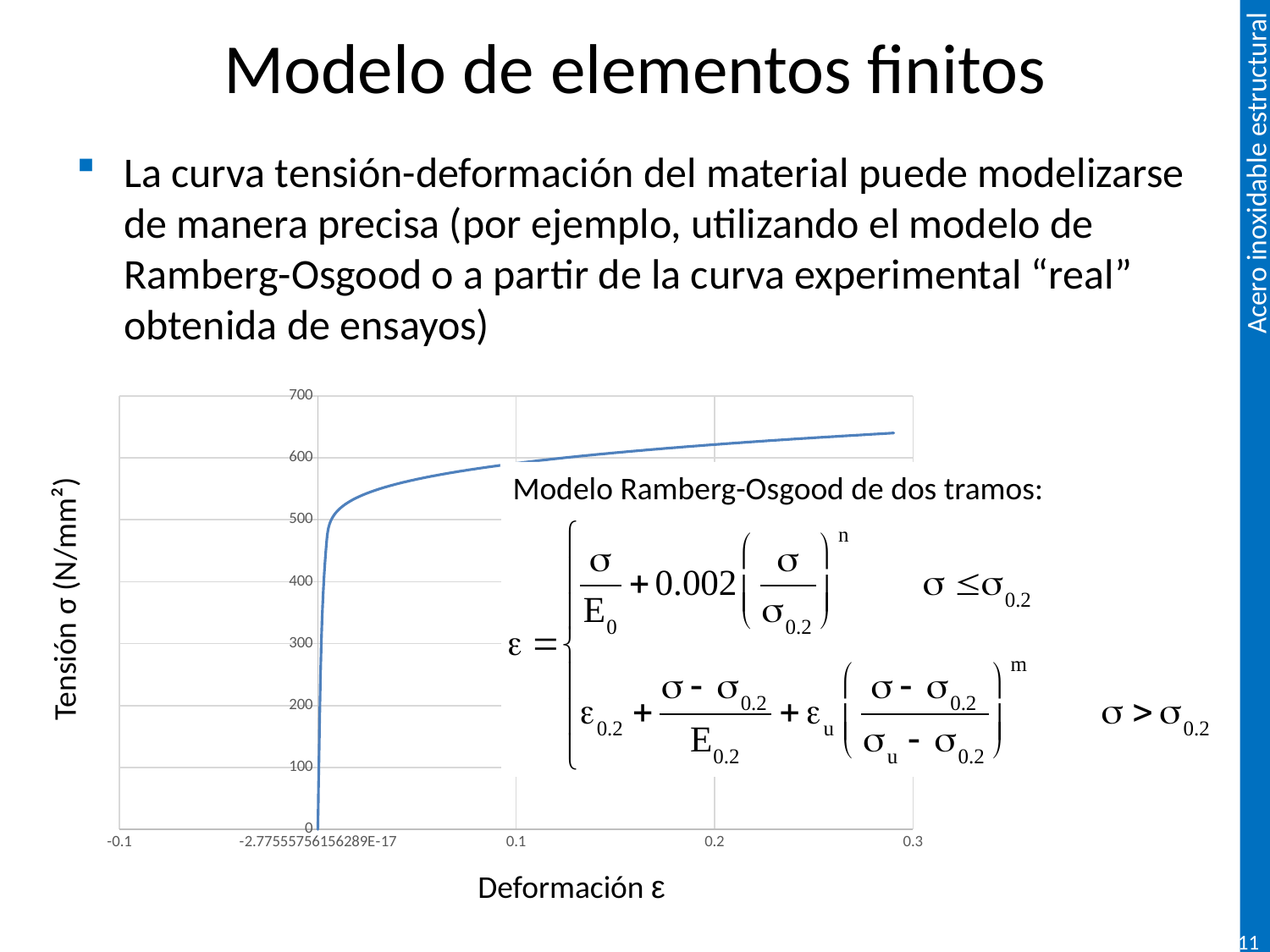
What kind of chart is shown on the slide? line chart Is the stress value at a strain of 0.1 greater or less than 400? greater How many curves (series) are plotted on the chart? 1 Does the stress value rise or fall as the strain increases along the x axis? rise What is the label of the horizontal axis of the chart? Deformación ε Is the highest stress value reached by the curve greater or less than 700? less Is the stress value at a strain of 0.2 greater or less than 500? greater What is the maximum value shown on the vertical axis of the chart? 700 What is the label of the vertical axis of the chart? Tensión σ (N/mm²)